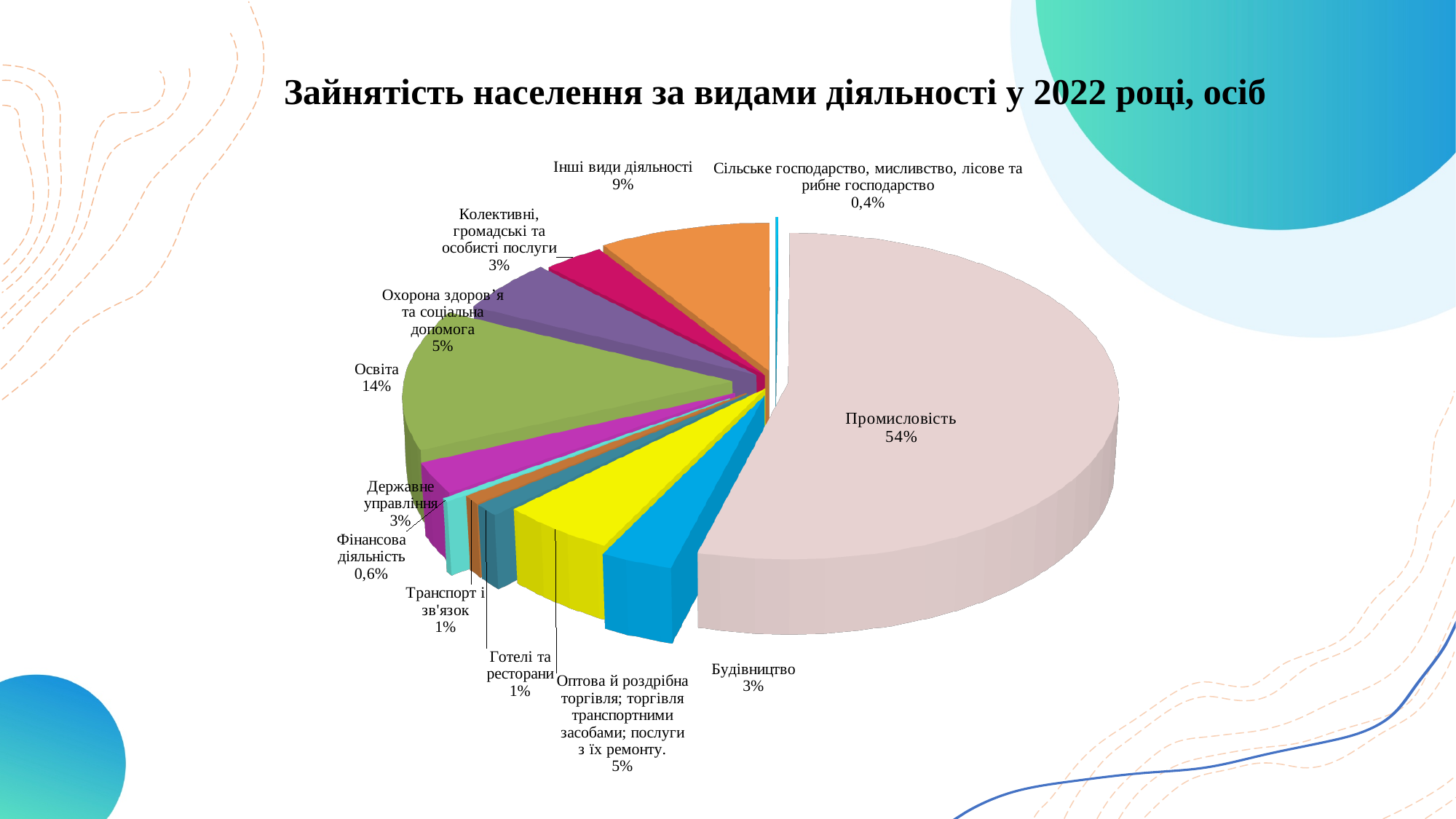
What is the difference in percentage points between Промисловість and Освіта? 40 What is the value shown for Будівництво? 3% Which is larger, the share for Освіта or the share for Інші види діяльності? Освіта What share of the pie does Промисловість account for? 54% What is the title of the chart? Зайнятість населення за видами діяльності у 2022 році, осіб How many categories (slices) does the pie chart have? 12 Which category has the largest share of the pie? Промисловість What is the value shown for Фінансова діяльність? 0,6% What is the value shown for Інші види діяльності? 9% What kind of chart is shown on the slide? pie chart Which category has the smallest share of the pie? Сільське господарство, мисливство, лісове та рибне господарство What is the value shown for Освіта? 14%